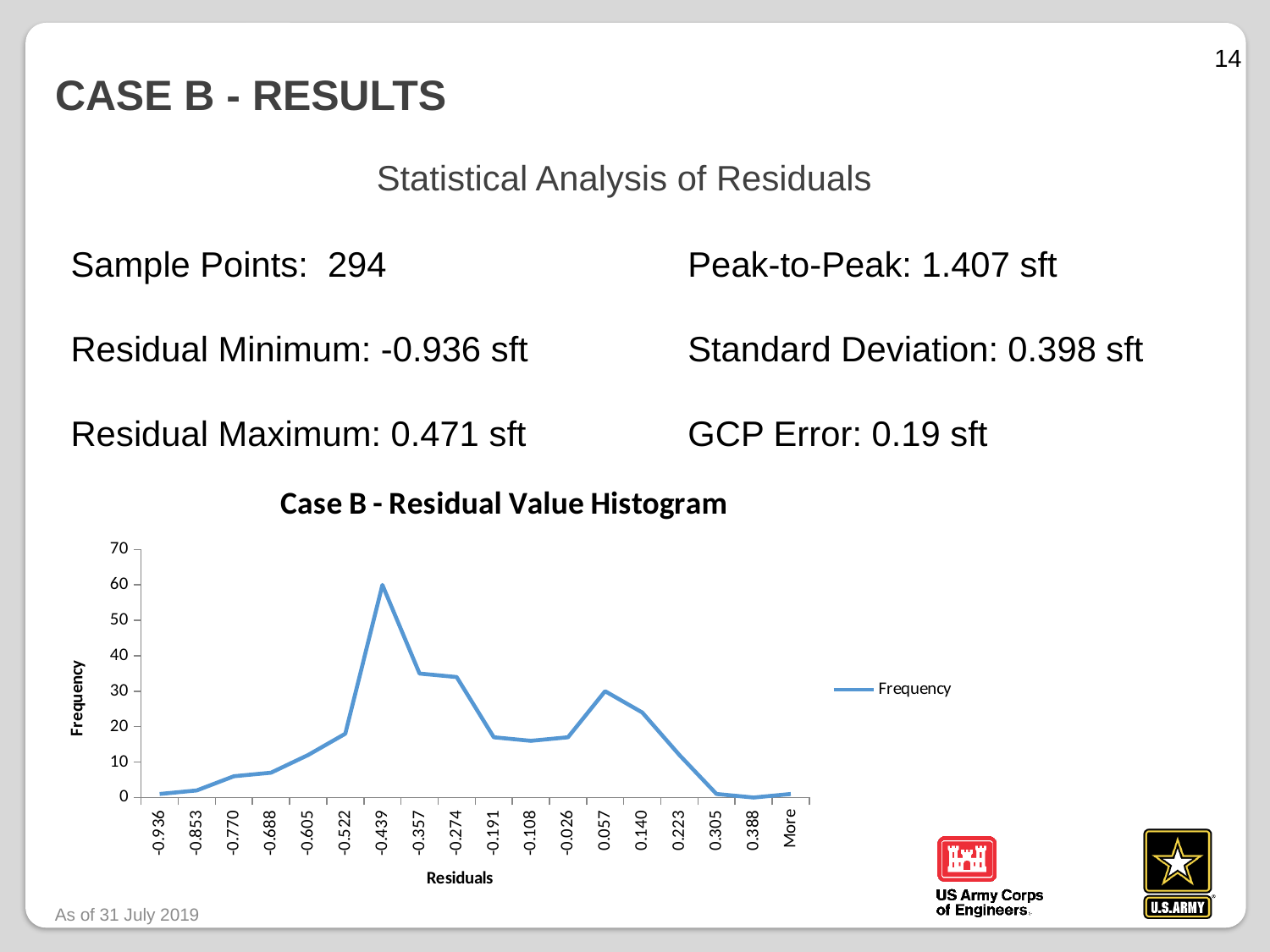
Which bin has the higher frequency, -0.439 or 0.057? -0.439 Which residual bin has the highest frequency in the Case B - Residual Value Histogram? -0.439 Is the frequency for the -0.439 bin greater or less than 50? greater What kind of chart is the Case B - Residual Value Histogram? line chart Is the frequency for the 0.057 bin greater or less than 40? less Which bin has the higher frequency, -0.522 or 0.140? 0.140 How many categories are shown on the x axis of the Case B - Residual Value Histogram? 18 What is the title of the chart on the slide? Case B - Residual Value Histogram How many series does the legend of the Case B - Residual Value Histogram list? 1 Does the frequency rise or fall from the 0.057 bin to the 0.305 bin? fall Is the frequency for the -0.357 bin greater or less than 30? greater